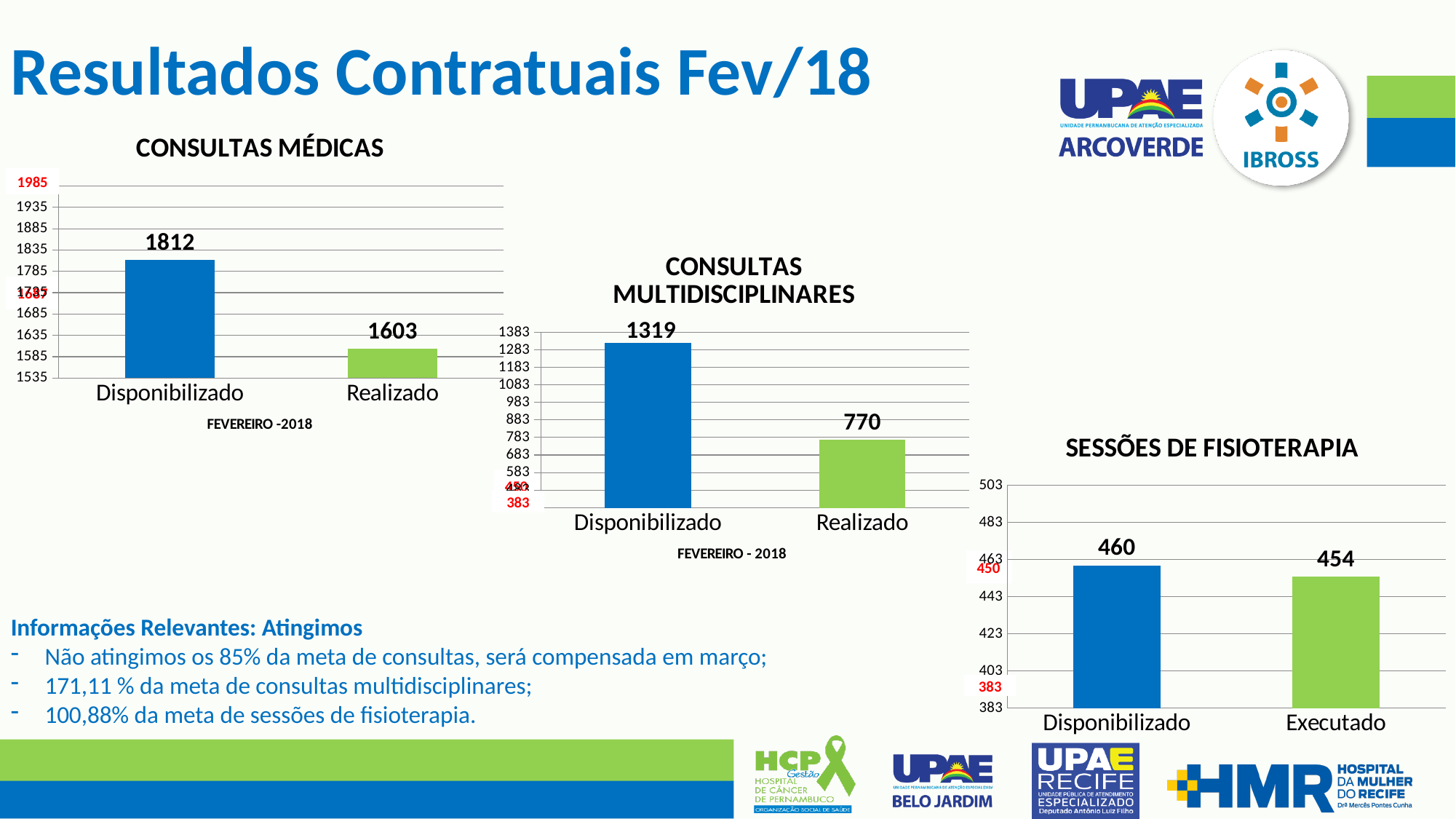
In the CONSULTAS MÉDICAS chart, what is the value for Realizado? 1603 How many categories does the SESSÕES DE FISIOTERAPIA chart show? 2 In the CONSULTAS MULTIDISCIPLINARES chart, what is the value for Realizado? 770 What kind of chart is the CONSULTAS MÉDICAS chart? Bar chart In the CONSULTAS MÉDICAS chart, what is the value for Disponibilizado? 1812 In the CONSULTAS MÉDICAS chart, what is the difference between Disponibilizado and Realizado? 209 In the CONSULTAS MULTIDISCIPLINARES chart, which category has the lowest value? Realizado In the CONSULTAS MULTIDISCIPLINARES chart, what is the value for Disponibilizado? 1319 In the SESSÕES DE FISIOTERAPIA chart, what is the value for Executado? 454 In the CONSULTAS MULTIDISCIPLINARES chart, what is the difference between Disponibilizado and Realizado? 549 In the SESSÕES DE FISIOTERAPIA chart, what is the difference between Disponibilizado and Executado? 6 In the SESSÕES DE FISIOTERAPIA chart, what is the value for Disponibilizado? 460